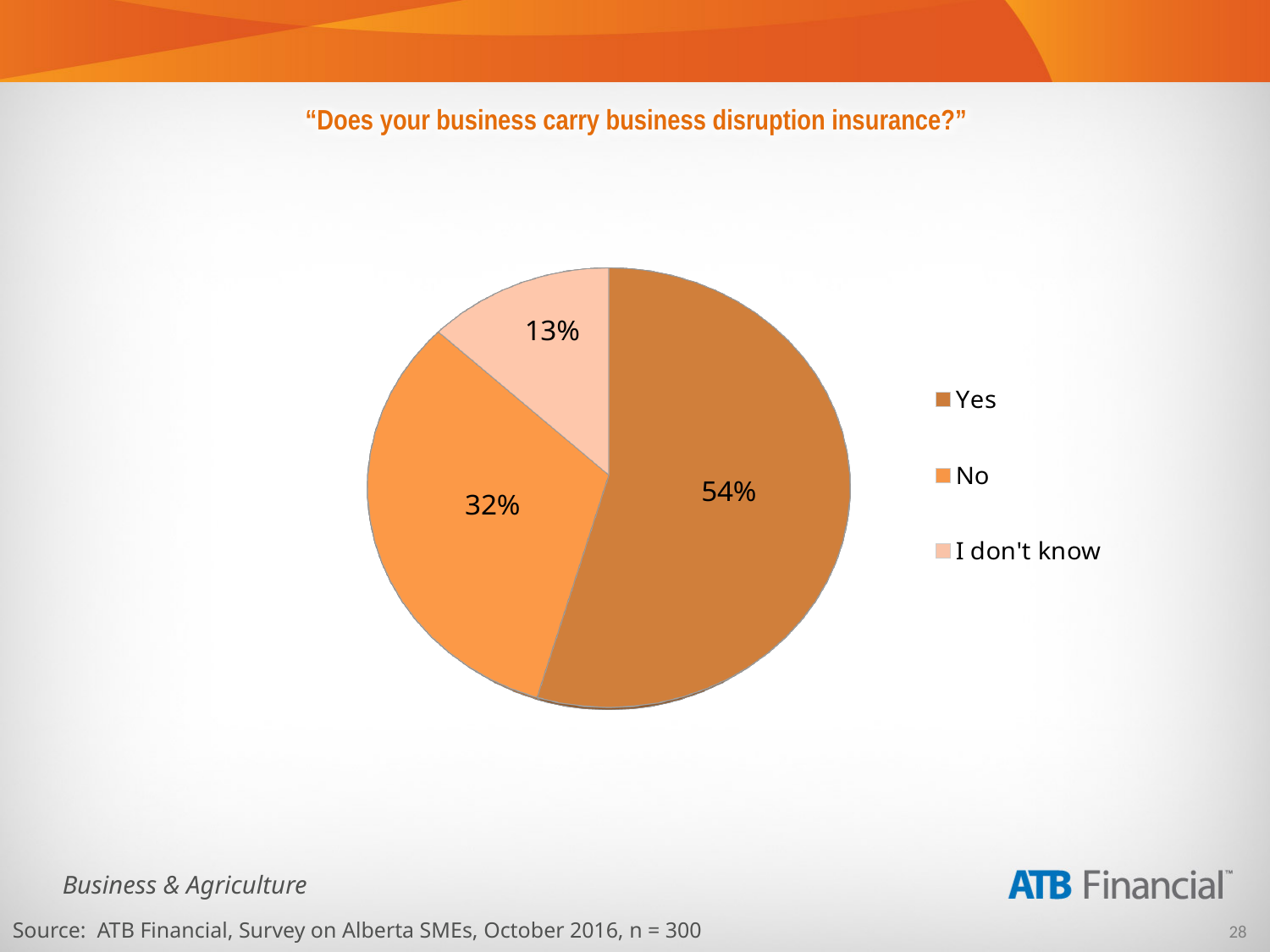
How many percentage points larger is the "No" share than the "I don't know" share? 19 Which is larger, the share for "No" or the share for "I don't know"? No How many percentage points larger is the "Yes" share than the "No" share? 22 How many entries does the legend list? 3 How many slices does the pie chart have? 3 Which response has the smallest share of the pie? I don't know What question is the chart titled with? "Does your business carry business disruption insurance?" What kind of chart is shown on the slide? pie chart What percentage of respondents answered "Yes"? 54% What percentage of respondents answered "No"? 32% What percentage of respondents answered "I don't know"? 13% Which response has the largest share of the pie? Yes